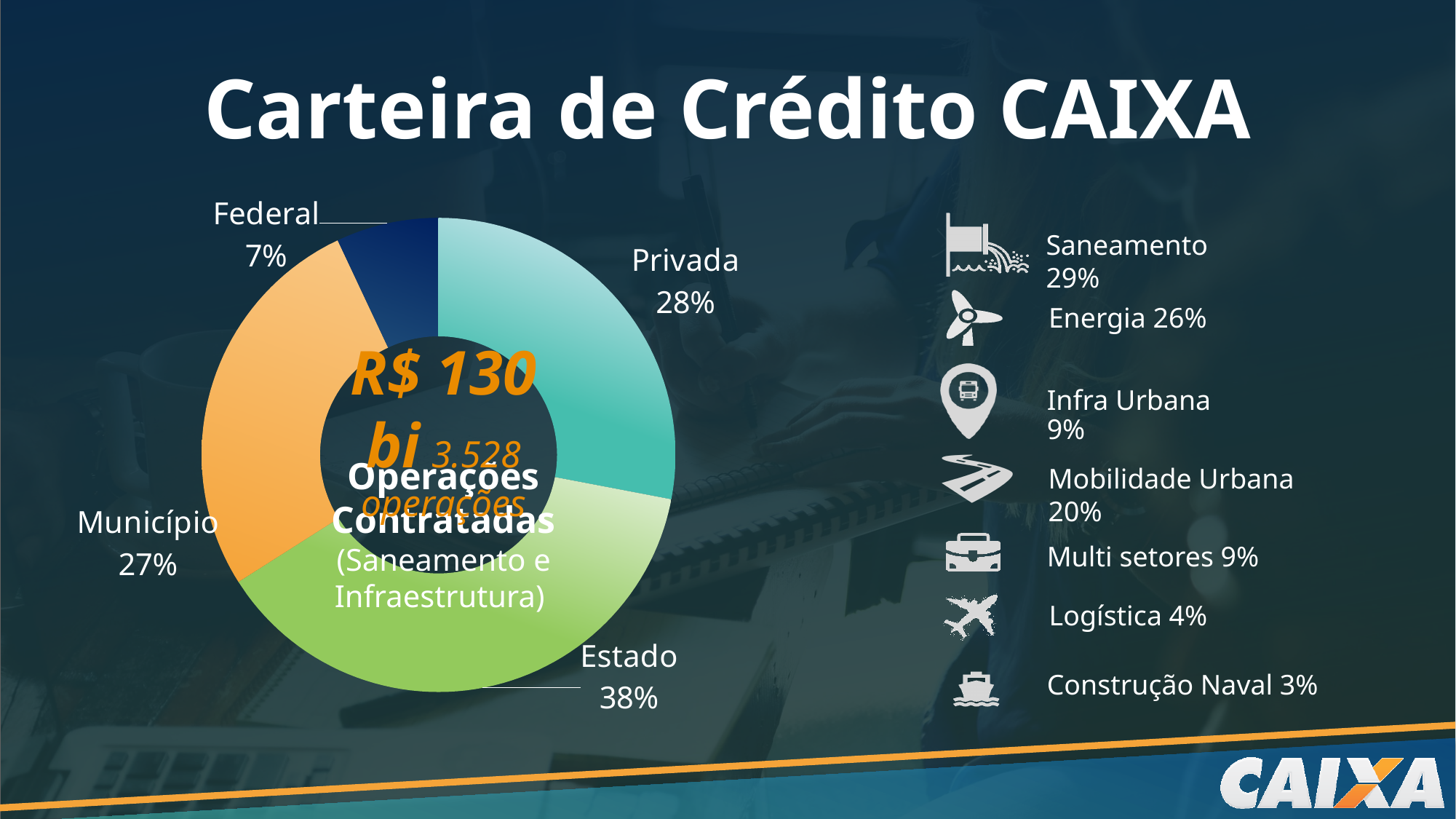
What percentage is shown for Federal in the donut chart? 7% What is the difference in percentage points between Município and Federal in the donut chart? 20 What share of the donut chart is labelled Estado? 38% What colour is the Município slice in the donut chart? Orange By how many percentage points does Estado exceed Privada in the donut chart? 10 Which is larger in the donut chart, Privada or Município? Privada What type of chart is shown on the left of the slide? Donut (pie) chart What is the value shown for Município in the donut chart? 27% What percentage does the Privada slice show in the donut chart? 28% Which category has the smallest slice in the donut chart? Federal Which category has the largest slice in the donut chart? Estado How many slices does the donut chart have? 4